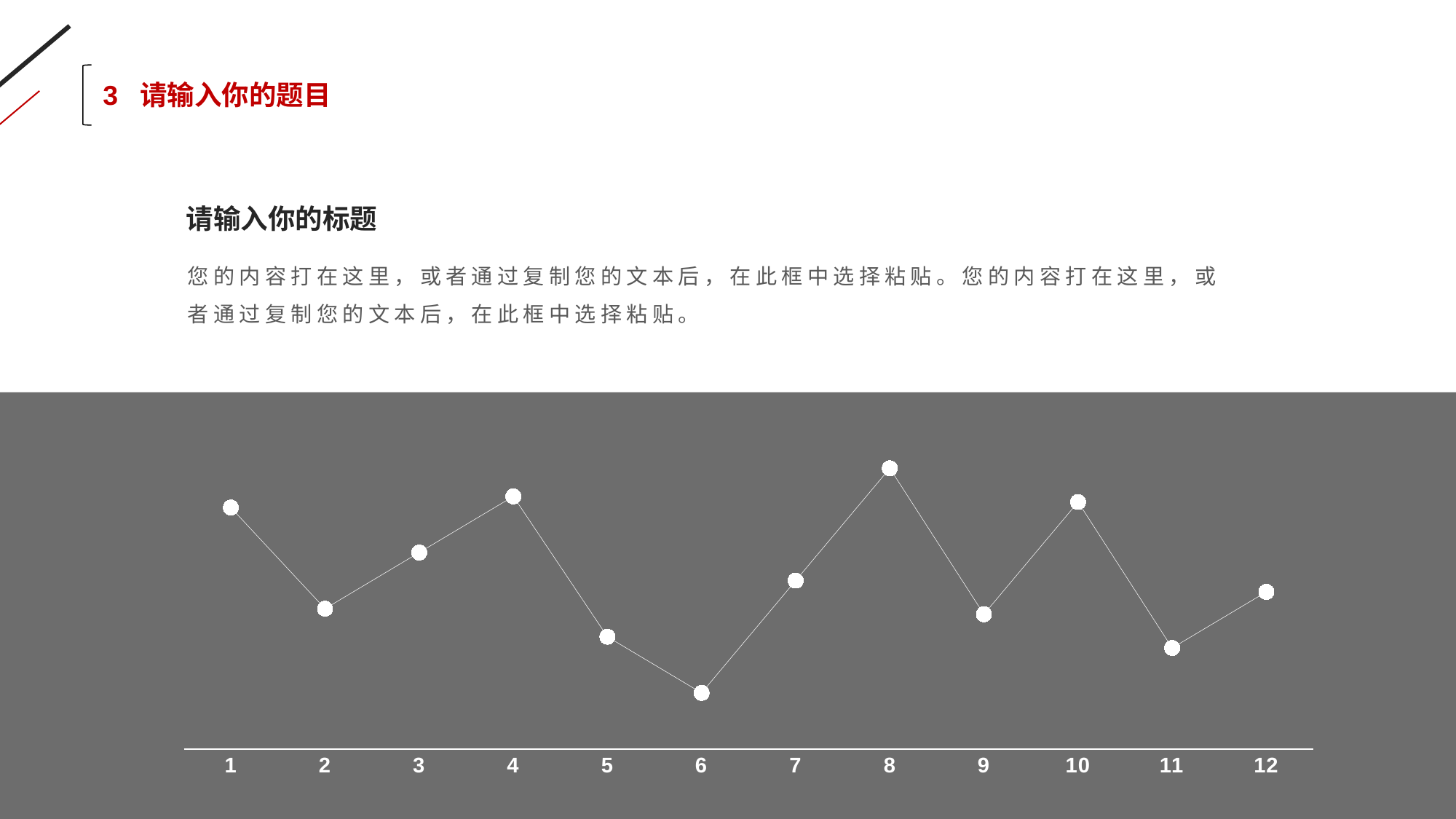
Which is higher on the line chart, the point at 1 or the point at 2? 1 Does the line rise or fall from category 5 to category 6? fall Which is higher on the line chart, the point at 10 or the point at 11? 10 Which is higher on the line chart, the point at 4 or the point at 5? 4 Does the line rise or fall from category 6 to category 8? rise What is the first category label on the x axis of the line chart? 1 What is the last category label on the x axis of the line chart? 12 Which category on the x axis has the lowest point on the line chart? 6 How many data points are plotted on the line chart? 12 What kind of chart is shown on the slide? line chart Which category on the x axis has the highest point on the line chart? 8